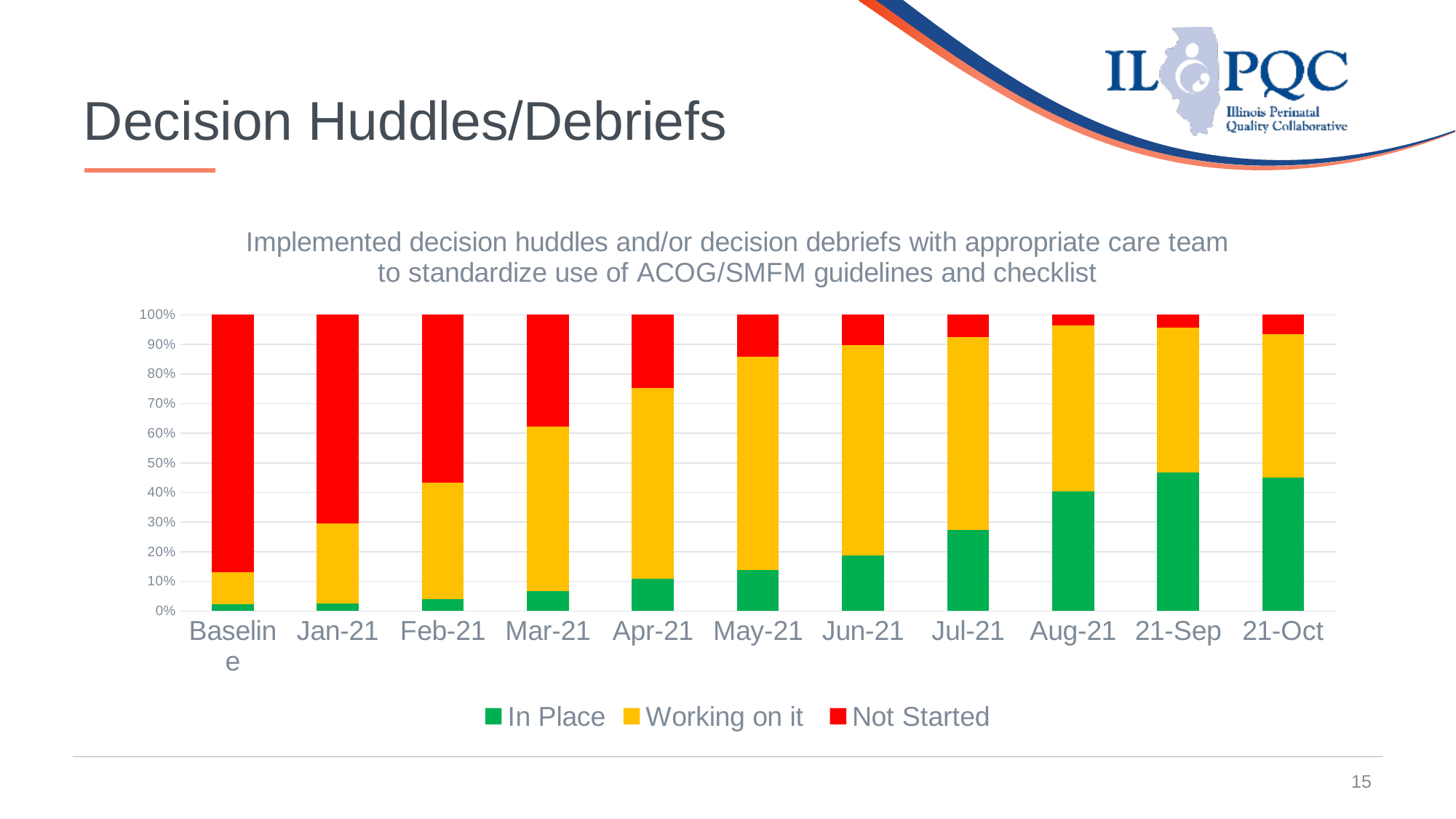
What does each stacked bar in the chart total? 100% Is the 'In Place' value for Jul-21 greater or less than 20%? greater Which category has the largest 'Not Started' share? Baseline How many series does the chart legend list? 3 Is the 'In Place' value for 21-Sep greater or less than 40%? greater Does the 'In Place' share generally rise or fall from Baseline to 21-Sep? Rise How many categories are shown along the x axis of the chart? 11 Which colour represents the 'Not Started' series in the chart? Red Is the 'In Place' value for Baseline greater or less than 10%? less What kind of chart is shown on the slide? Stacked bar chart Which is larger, the 'In Place' share for Jul-21 or for Mar-21? Jul-21 What are the three series listed in the chart legend? In Place, Working on it, Not Started